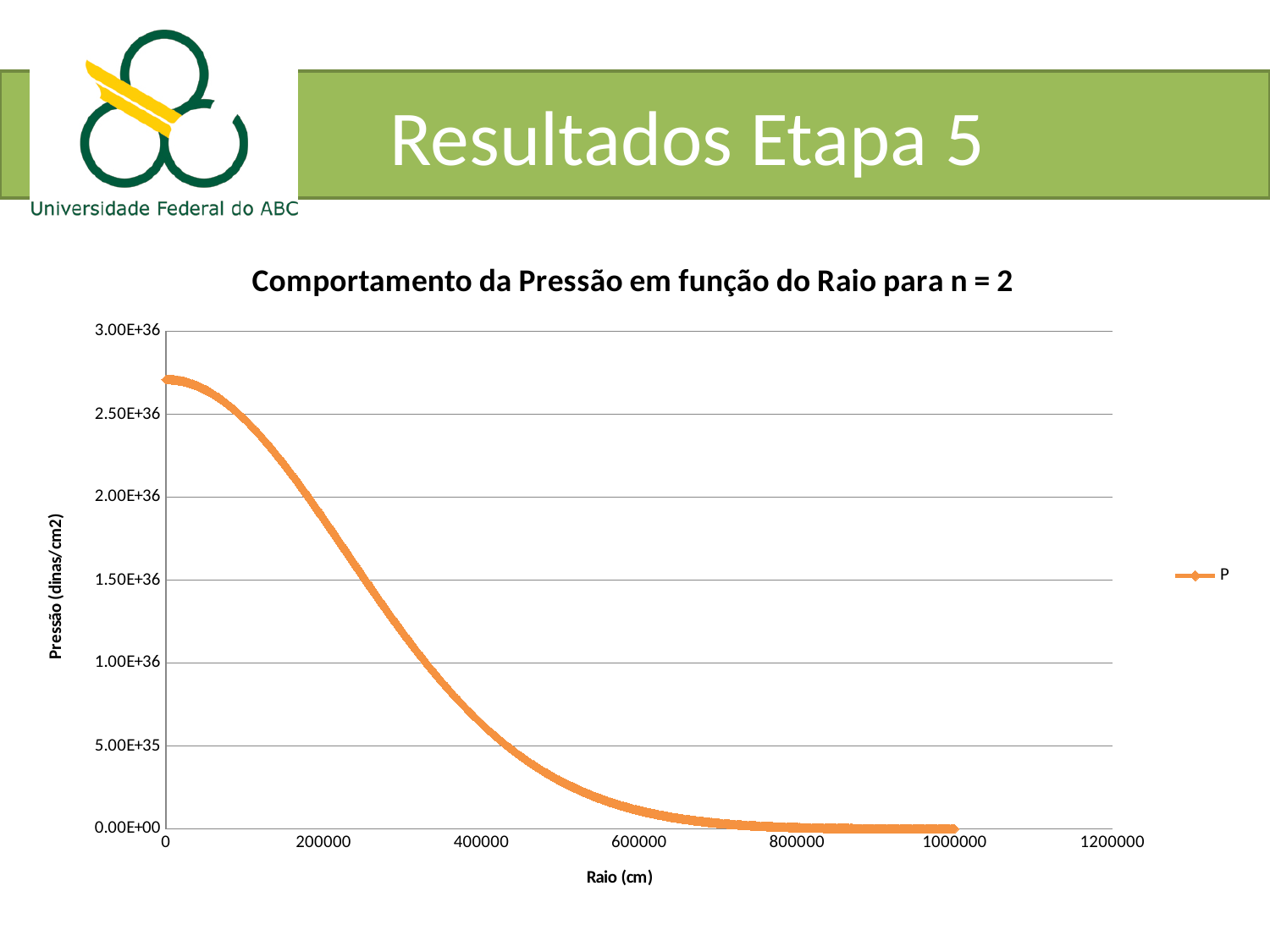
Does the pressure rise or fall as the radius increases along the x axis? fall Which radius has the higher pressure, 200000 or 600000? 200000 At which radius shown on the x axis is the pressure highest? 0 What is the name of the series shown in the legend? P Is the pressure at a radius of 400000 greater or less than 1.00E+36? less Is the pressure at a radius of 800000 greater or less than 5.00E+35? less Is the pressure at a radius of 0 greater or less than 2.50E+36? greater What is the title of the chart? Comportamento da Pressão em função do Raio para n = 2 How many series does the legend list? 1 What kind of chart is shown on the slide? line chart